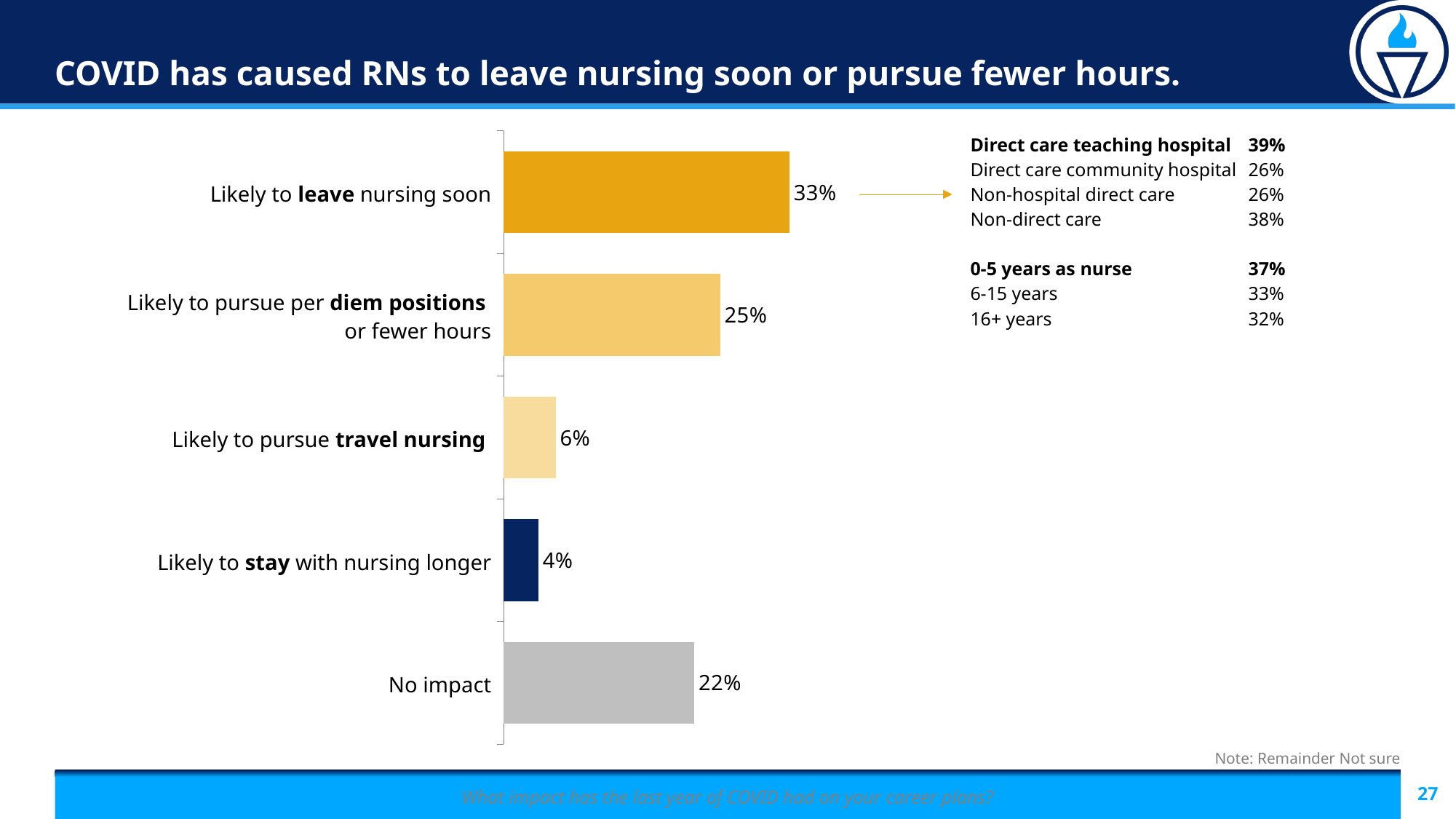
What is the value for 'Likely to pursue per diem positions or fewer hours'? 25% What percentage of RNs are likely to pursue travel nursing? 6% Which category has the lowest value? Likely to stay with nursing longer What is the difference between 'Likely to leave nursing soon' and 'No impact'? 11% Which is larger: 'Likely to pursue travel nursing' or 'Likely to stay with nursing longer'? Likely to pursue travel nursing How many categories are shown in the bar chart? 5 Which category has the highest value? Likely to leave nursing soon In the breakdown next to the top bar, what percentage of direct care teaching hospital nurses are likely to leave nursing soon? 39% What percentage of RNs are likely to leave nursing soon? 33% What is the value for 'No impact'? 22% In the breakdown by years as nurse, what is the value for 16+ years? 32% What kind of chart is shown on the slide? Bar chart